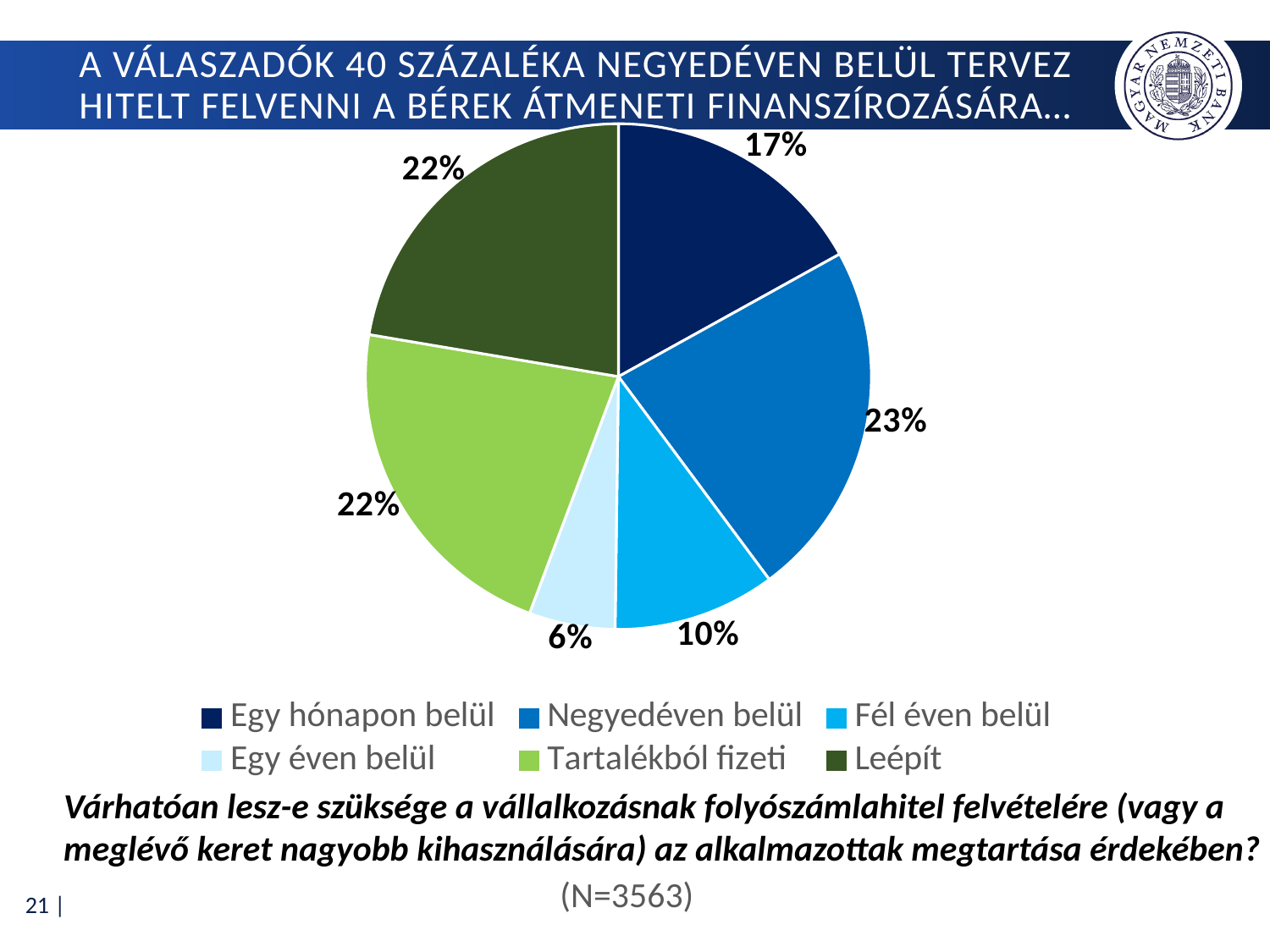
What is the difference between the shares of "Negyedéven belül" and "Egy hónapon belül"? 6 percentage points What is the sample size (N) stated below the chart? N=3563 What is the value for "Fél éven belül"? 10% Which is larger, the share for "Leépít" or the share for "Fél éven belül"? Leépít What percentage is shown for "Egy hónapon belül"? 17% Which category has the smallest slice of the pie? Egy éven belül Which category has the largest slice of the pie? Negyedéven belül What percentage is shown for "Egy éven belül"? 6% What share of the pie does "Negyedéven belül" represent? 23% What type of chart is shown on the slide? Pie chart What share does "Tartalékból fizeti" have in the pie? 22% How many categories does the pie chart show? 6